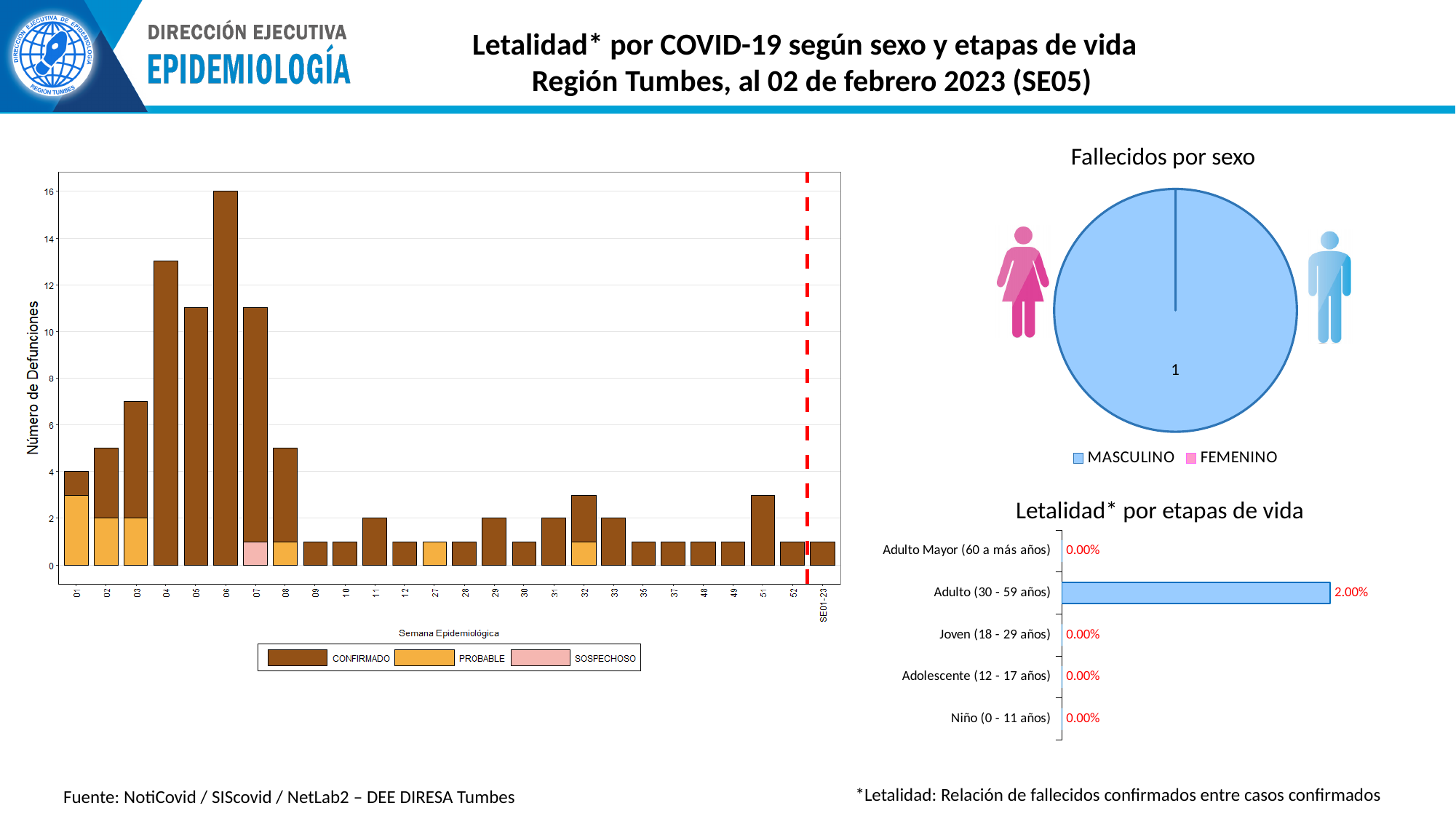
How many age-group categories are shown in the 'Letalidad* por etapas de vida' chart? 5 In the 'Letalidad* por etapas de vida' chart, what is the difference between the values for Adulto (30 - 59 años) and Joven (18 - 29 años)? 2.00% In the 'Número de Defunciones' bar chart on the left, which epidemiological week has the highest number of deaths? 06 In the 'Letalidad* por etapas de vida' chart, what is the value for Adulto Mayor (60 a más años)? 0.00% In the 'Letalidad* por etapas de vida' chart, what is the value for Adulto (30 - 59 años)? 2.00% What kind of chart is 'Letalidad* por etapas de vida'? Bar chart In the 'Número de Defunciones' bar chart on the left, how many series does the legend list? 3 In the 'Fallecidos por sexo' pie chart, what value is shown for MASCULINO? 1 How many entries does the legend of the 'Fallecidos por sexo' pie chart list? 2 In the 'Letalidad* por etapas de vida' chart, which age group has the highest value? Adulto (30 - 59 años) In the 'Número de Defunciones' bar chart on the left, is the value for week 04 greater or less than 10? greater In the 'Número de Defunciones' bar chart on the left, which of weeks 03 and 08 has the larger value? 03